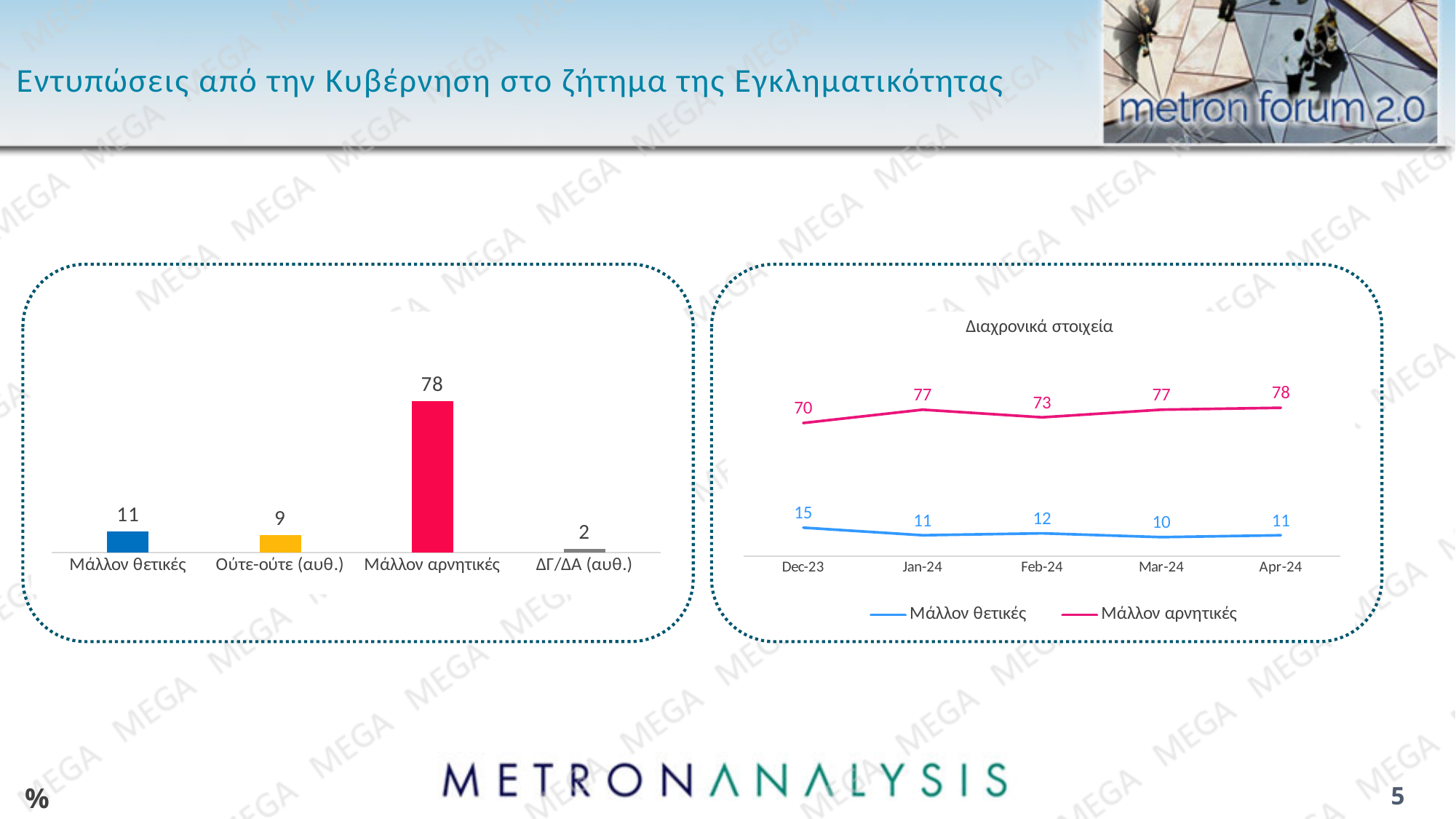
In the Διαχρονικά στοιχεία chart, what is the value for Μάλλον θετικές in Dec-23? 15 In the Διαχρονικά στοιχεία chart, in which month is Μάλλον αρνητικές highest? Apr-24 In the bar chart on the left, how many categories are shown? 4 In the bar chart on the left, what is the value for Ούτε-ούτε (αυθ.)? 9 In the bar chart on the left, which category has the lowest value? ΔΓ/ΔΑ (αυθ.) What kind of chart is the chart on the left? bar chart In the Διαχρονικά στοιχεία chart, is Μάλλον θετικές in Jan-24 larger or smaller than in Feb-24? smaller In the bar chart on the left, what is the difference between Μάλλον αρνητικές and Μάλλον θετικές? 67 In the Διαχρονικά στοιχεία chart, what is the value for Μάλλον αρνητικές in Feb-24? 73 In the Διαχρονικά στοιχεία chart, what is the difference between Μάλλον αρνητικές and Μάλλον θετικές in Apr-24? 67 In the bar chart on the left, what is the value for Μάλλον αρνητικές? 78 In the Διαχρονικά στοιχεία chart, how many series does the legend list? 2